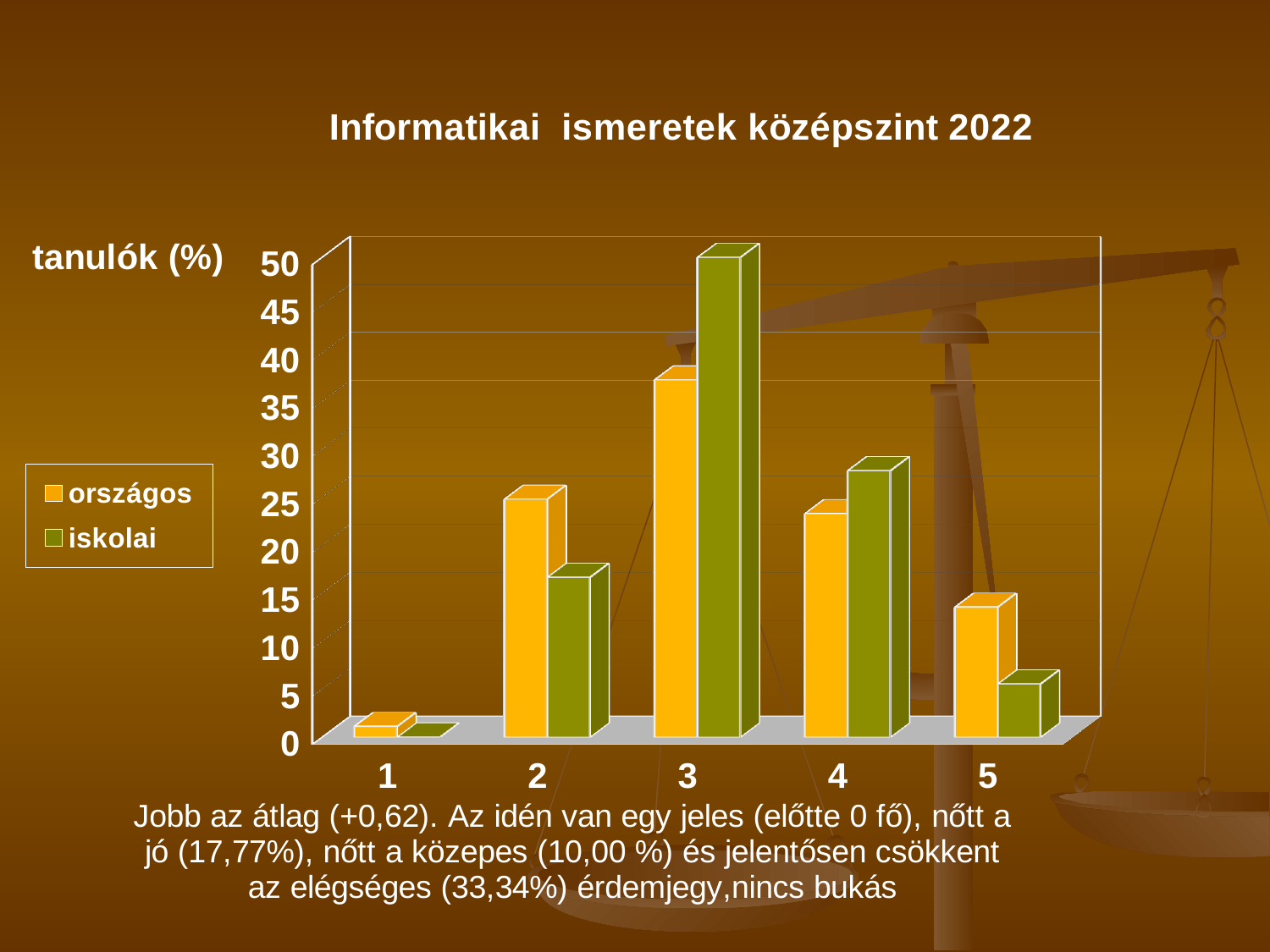
What label is shown on the vertical axis? tanulók (%) How many series does the legend list? 2 What is the title of the chart? Informatikai ismeretek középszint 2022 Is the országos value for category 3 greater or less than 35? greater For which category is the országos value highest? 3 For category 2, which series has the larger value, országos or iskolai? országos Is the iskolai value for category 5 greater or less than 10? less What kind of chart is shown on the slide? bar chart For category 3, which series has the larger value, országos or iskolai? iskolai For which category is the iskolai value highest? 3 For which category is the iskolai value lowest? 1 How many categories are shown on the x axis? 5